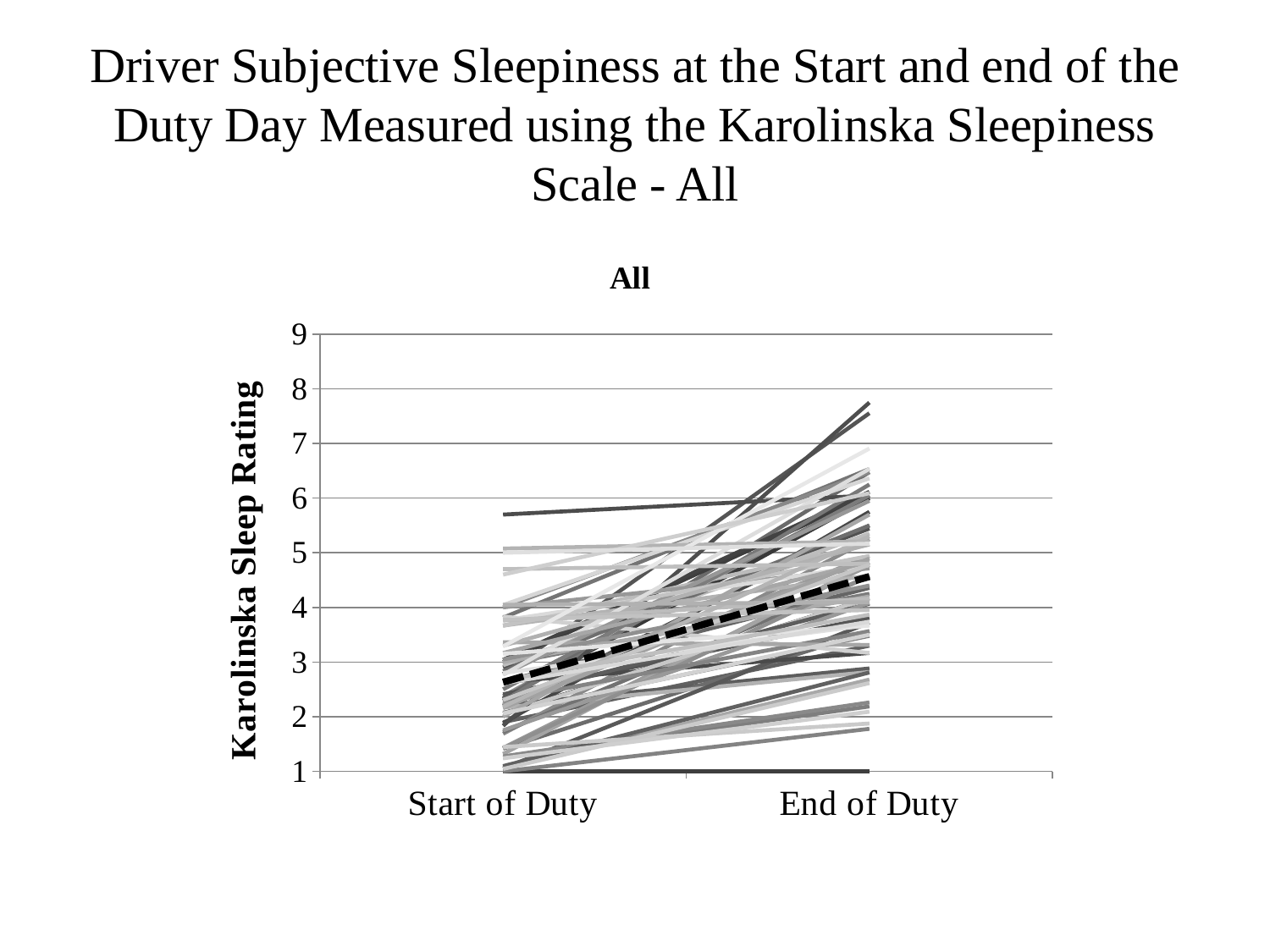
How many categories are shown on the horizontal axis? 2 Is the value of the thick dashed line at Start of Duty greater or less than 3? less What is the label on the vertical axis of the chart? Karolinska Sleep Rating What are the two categories on the horizontal axis? Start of Duty and End of Duty Does the thick dashed line rise or fall from Start of Duty to End of Duty? rise What is the title printed above the chart? All Is the thick dashed line higher at Start of Duty or at End of Duty? End of Duty Is the highest line value at Start of Duty greater or less than 6? less What kind of chart is shown on the slide? line chart Is the highest line value at End of Duty greater or less than 7? greater